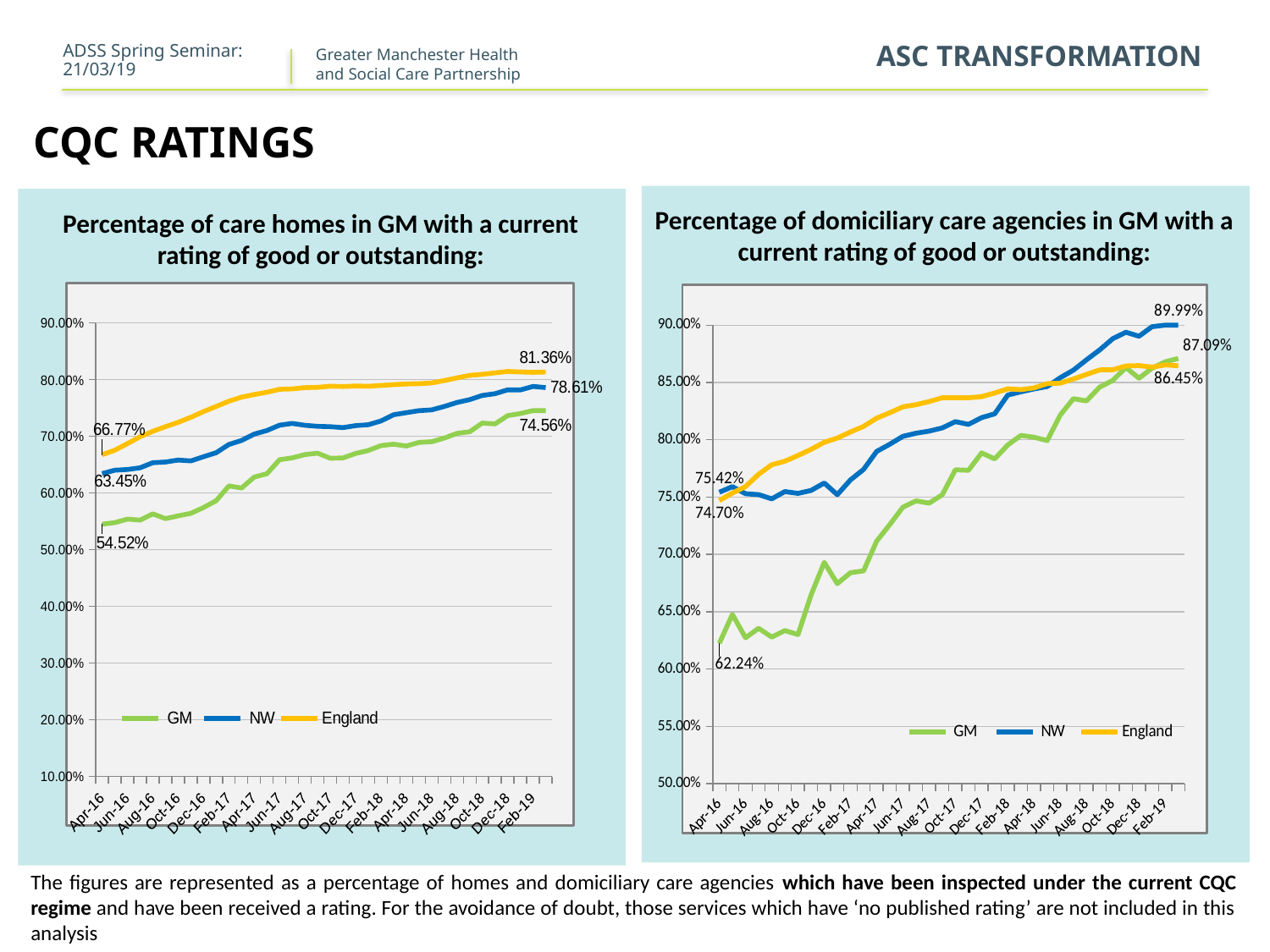
In the 'Percentage of domiciliary care agencies in GM with a current rating of good or outstanding' chart, what is the value for GM in Apr-16? 62.24% In the 'Percentage of domiciliary care agencies in GM with a current rating of good or outstanding' chart, what is the starting value for England in Apr-16? 74.70% In the 'Percentage of domiciliary care agencies in GM with a current rating of good or outstanding' chart, what is the final value for NW? 89.99% How many series does the legend list in the 'Percentage of care homes in GM with a current rating of good or outstanding' chart? 3 In the 'Percentage of care homes in GM with a current rating of good or outstanding' chart, which series has the highest value at Feb-19? England In the 'Percentage of care homes in GM with a current rating of good or outstanding' chart, what is the final value for England in Feb-19? 81.36% In the 'Percentage of care homes in GM with a current rating of good or outstanding' chart, what is the final value for NW? 78.61% In the 'Percentage of care homes in GM with a current rating of good or outstanding' chart, by how much did the GM value increase from Apr-16 to Feb-19? 20.04 percentage points In the 'Percentage of care homes in GM with a current rating of good or outstanding' chart, what is the value for GM in Apr-16? 54.52% In the 'Percentage of domiciliary care agencies in GM with a current rating of good or outstanding' chart, which series has the lowest value at Feb-19? England In the 'Percentage of care homes in GM with a current rating of good or outstanding' chart, does the GM value rise or fall over time? rise In the 'Percentage of domiciliary care agencies in GM with a current rating of good or outstanding' chart, is the final GM value (87.09%) larger or smaller than the final England value (86.45%)? larger